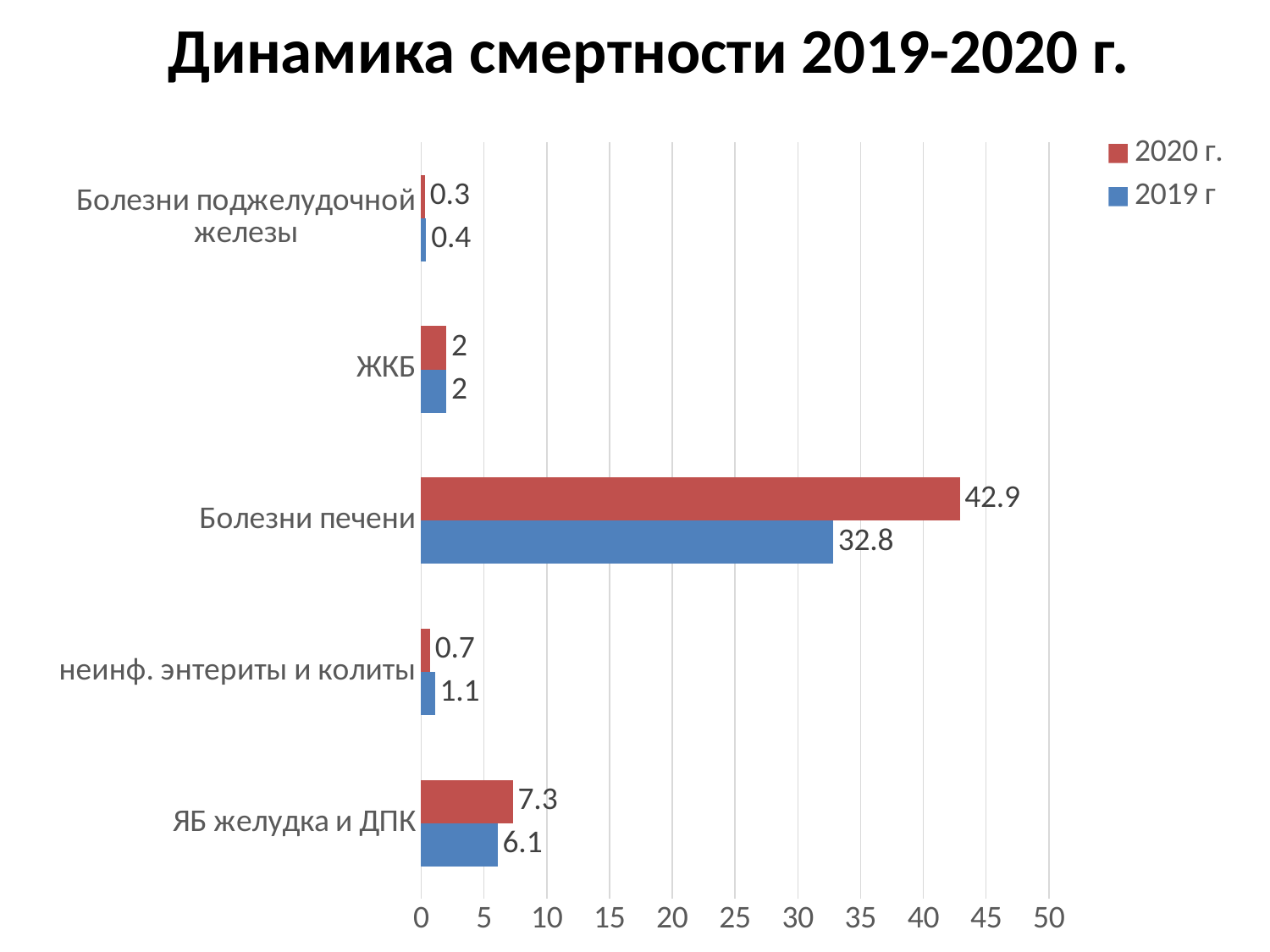
What is the difference between the 2020 г. and 2019 г values for Болезни печени? 10.1 What is the 2020 г. value for Болезни печени? 42.9 What is the 2019 г value for неинф. энтериты и колиты? 1.1 What is the 2020 г. value for Болезни поджелудочной железы? 0.3 What kind of chart is shown on the slide? Bar chart What is the title of the chart? Динамика смертности 2019-2020 г. Which is larger for ЯБ желудка и ДПК: the 2020 г. value or the 2019 г value? 2020 г. How many categories are shown on the chart? 5 Which category has the lowest 2019 г value? Болезни поджелудочной железы Which category has the highest 2020 г. value? Болезни печени How many series does the legend list? 2 What is the 2019 г value for ЯБ желудка и ДПК? 6.1